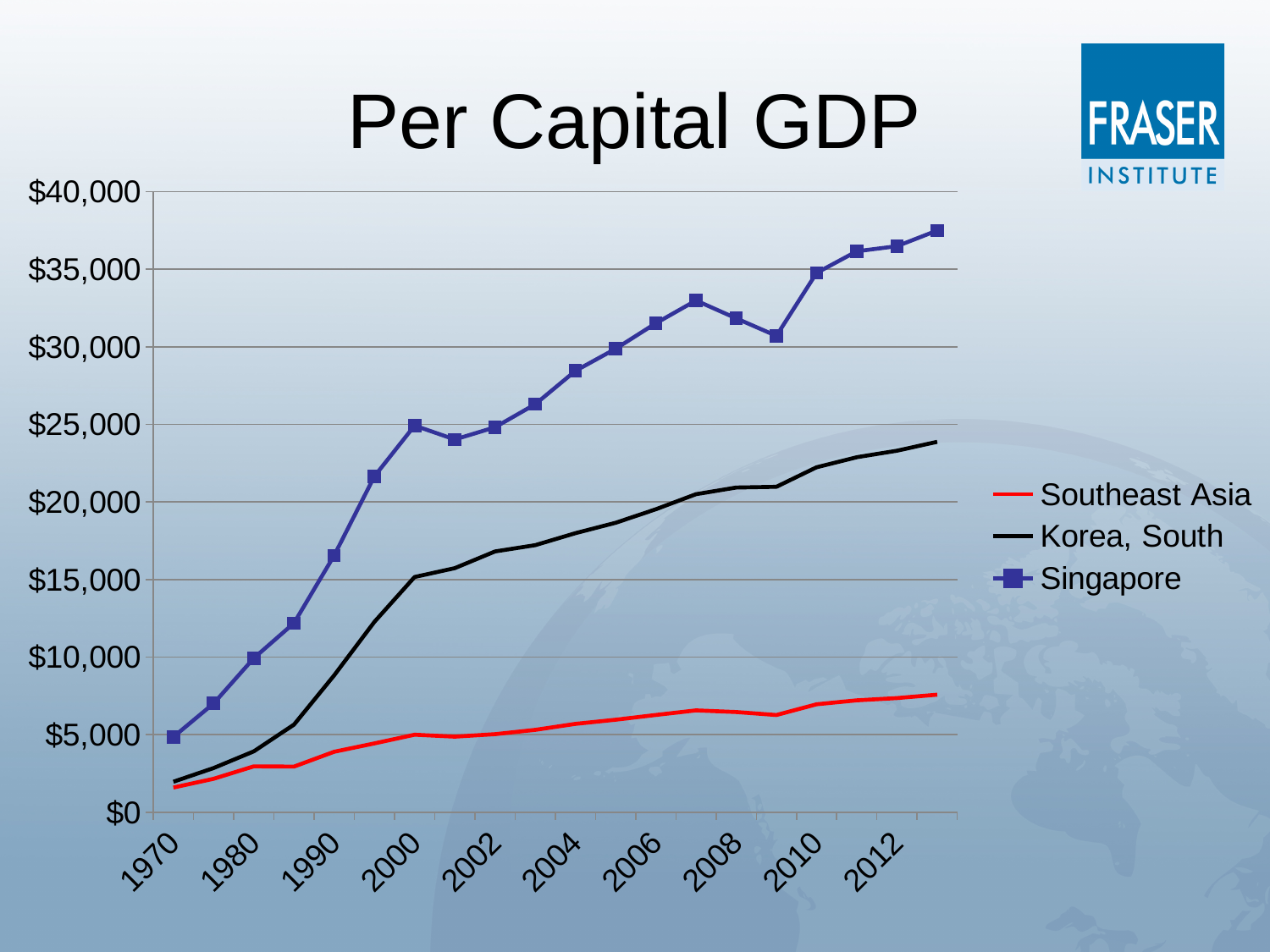
Which series has the lowest value in 2012? Southeast Asia Is the value for Southeast Asia in 2012 greater or less than $10,000? less Is the value for Korea, South in 2012 greater or less than $20,000? greater Which series has the highest value in 2012? Singapore Which is larger in 2000, the value for Korea, South or the value for Southeast Asia? Korea, South What kind of chart is shown on the slide? line chart Is the value for Korea, South in 1980 greater or less than $5,000? less How many series does the legend list? 3 What is the title of the chart? Per Capital GDP Which series is drawn with square markers? Singapore Does the value for Korea, South rise or fall from 1970 to 2012? rise